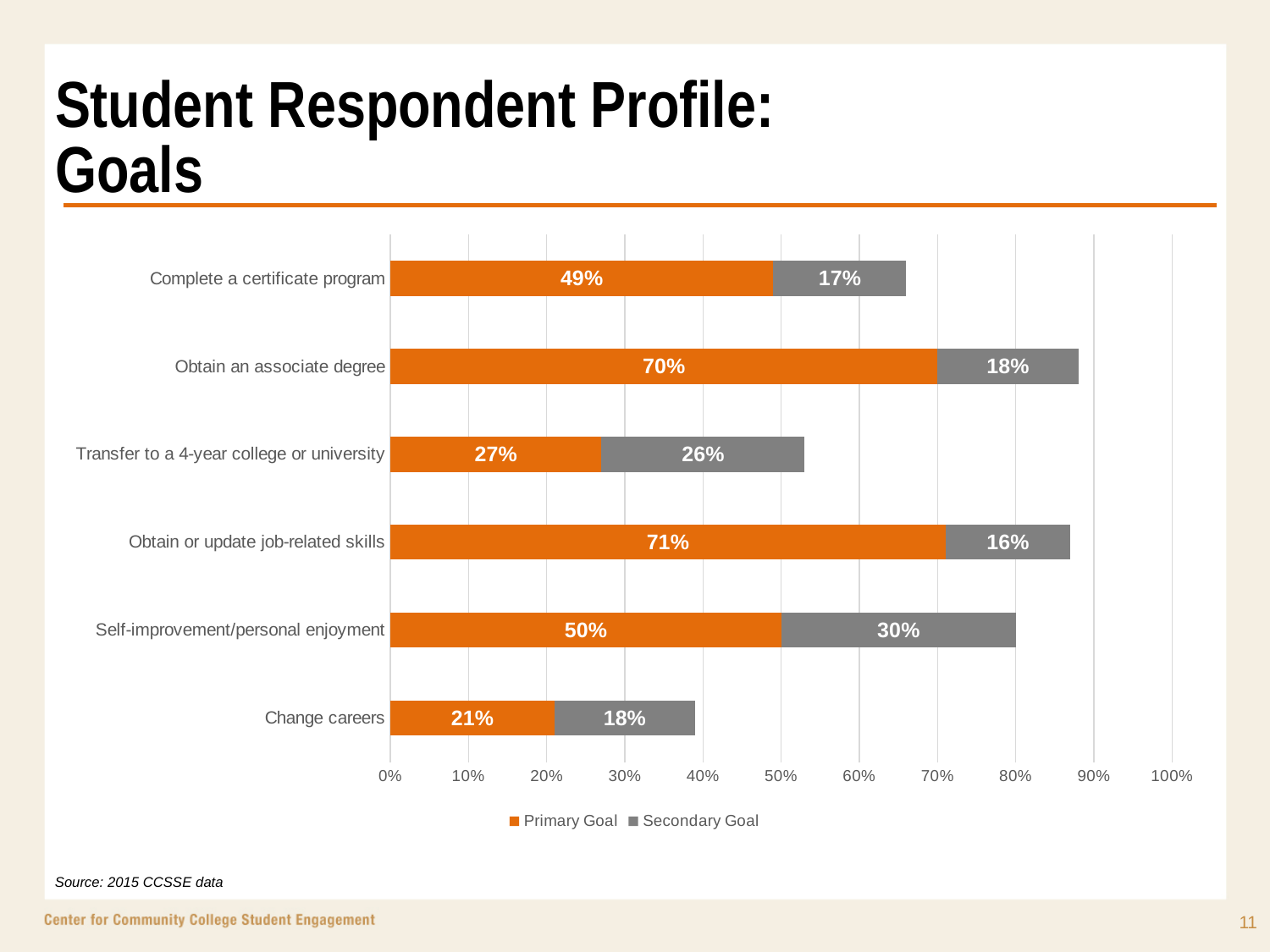
Which goal has the lowest Primary Goal percentage? Change careers What is the difference between the Primary Goal and Secondary Goal values for 'Transfer to a 4-year college or university'? 1% How many goal categories are shown on the chart? 6 How many series does the legend list? 2 Which series is shown in orange in the legend? Primary Goal What is the combined total of Primary Goal and Secondary Goal for 'Obtain or update job-related skills'? 87% What is the Secondary Goal value for 'Self-improvement/personal enjoyment'? 30% What percentage of respondents listed 'Obtain an associate degree' as a Primary Goal? 70% What kind of chart is shown on the slide? Stacked bar chart Which goal has the highest Primary Goal percentage? Obtain or update job-related skills Which is larger: the Primary Goal value for 'Complete a certificate program' or the Primary Goal value for 'Self-improvement/personal enjoyment'? Self-improvement/personal enjoyment What is the combined total of Primary Goal and Secondary Goal for 'Change careers'? 39%